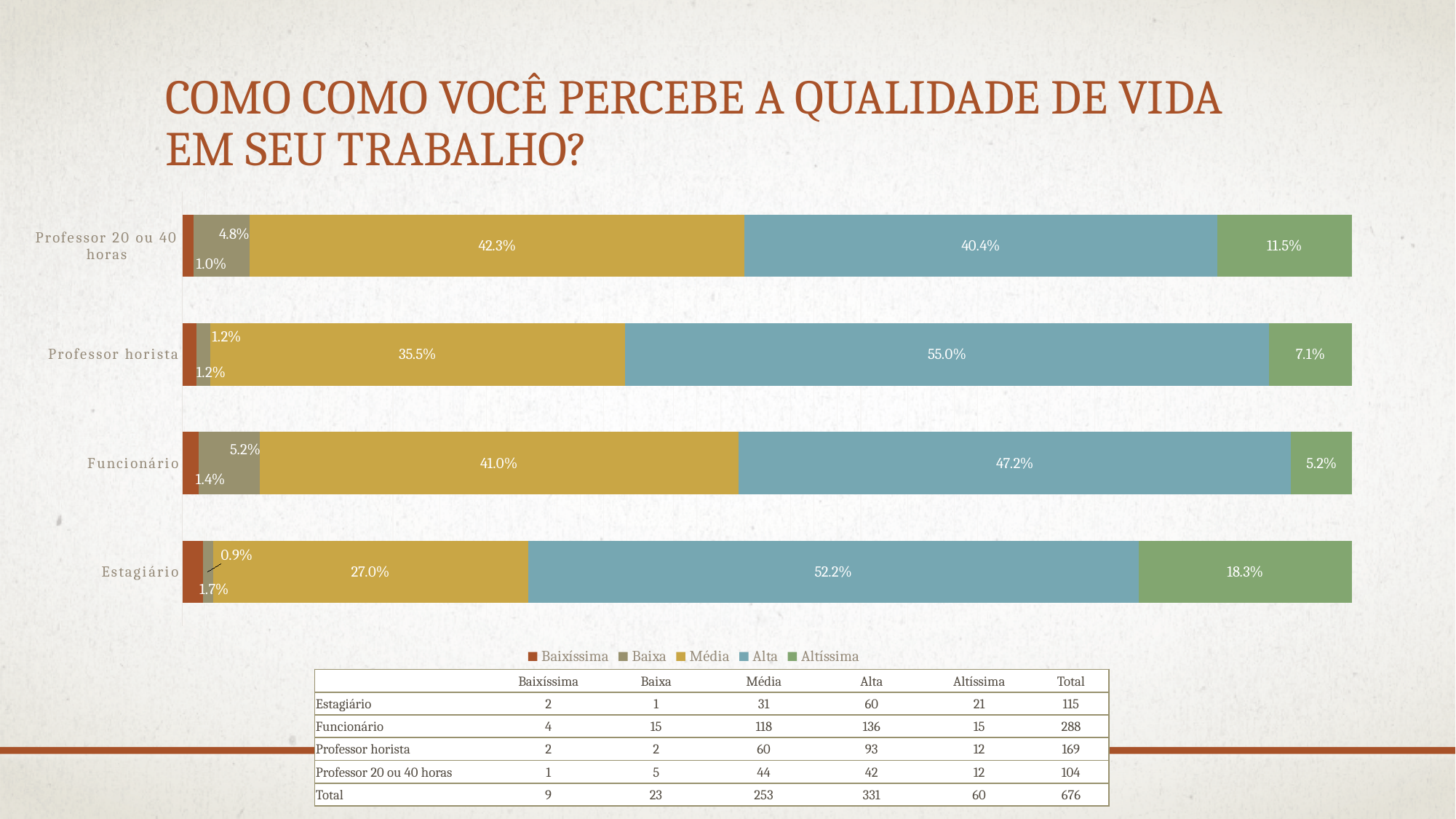
How many series does the legend list? 5 What is the Baixa value for Funcionário? 5.2% What kind of chart is shown on the slide? Stacked bar chart What is the Média value for Estagiário? 27.0% Which is larger: the Média share for Professor 20 ou 40 horas or for Professor horista? Professor 20 ou 40 horas What percentage of Professor horista respondents rated quality of life as Alta? 55.0% What is the Altíssima value for Professor 20 ou 40 horas? 11.5% What is the difference between the Altíssima share for Estagiário and for Funcionário? 13.1 percentage points Which category has the highest Altíssima share? Estagiário Which category has the highest Alta share? Professor horista Which category has the lowest Altíssima share? Funcionário How many categories (job types) are shown in the chart? 4